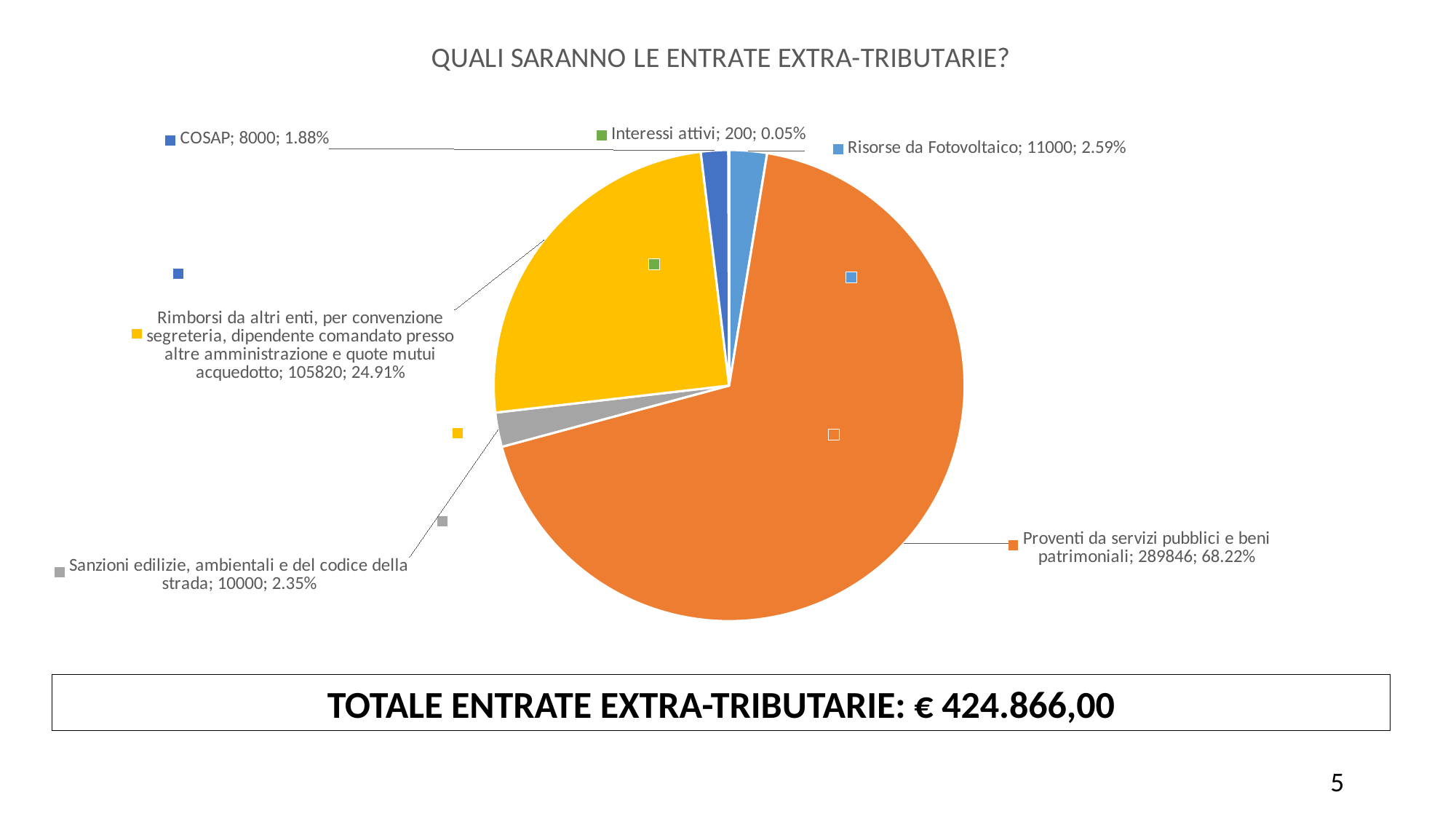
What is the difference between the value for Risorse da Fotovoltaico and the value for Sanzioni edilizie, ambientali e del codice della strada? 1000 What is the value for Interessi attivi? 200 How many slices does the pie chart have? 6 Which is larger: the value for COSAP or the value for Sanzioni edilizie, ambientali e del codice della strada? Sanzioni edilizie, ambientali e del codice della strada What kind of chart is shown on the slide? pie chart What is the title of the chart? QUALI SARANNO LE ENTRATE EXTRA-TRIBUTARIE? Which category has the smallest slice of the pie? Interessi attivi What share of the pie does Proventi da servizi pubblici e beni patrimoniali represent? 68.22% Which category has the largest slice of the pie? Proventi da servizi pubblici e beni patrimoniali What is the value for COSAP? 8000 What share of the pie does Risorse da Fotovoltaico represent? 2.59% What colour is the slice for Rimborsi da altri enti, per convenzione segreteria, dipendente comandato presso altre amministrazione e quote mutui acquedotto? yellow